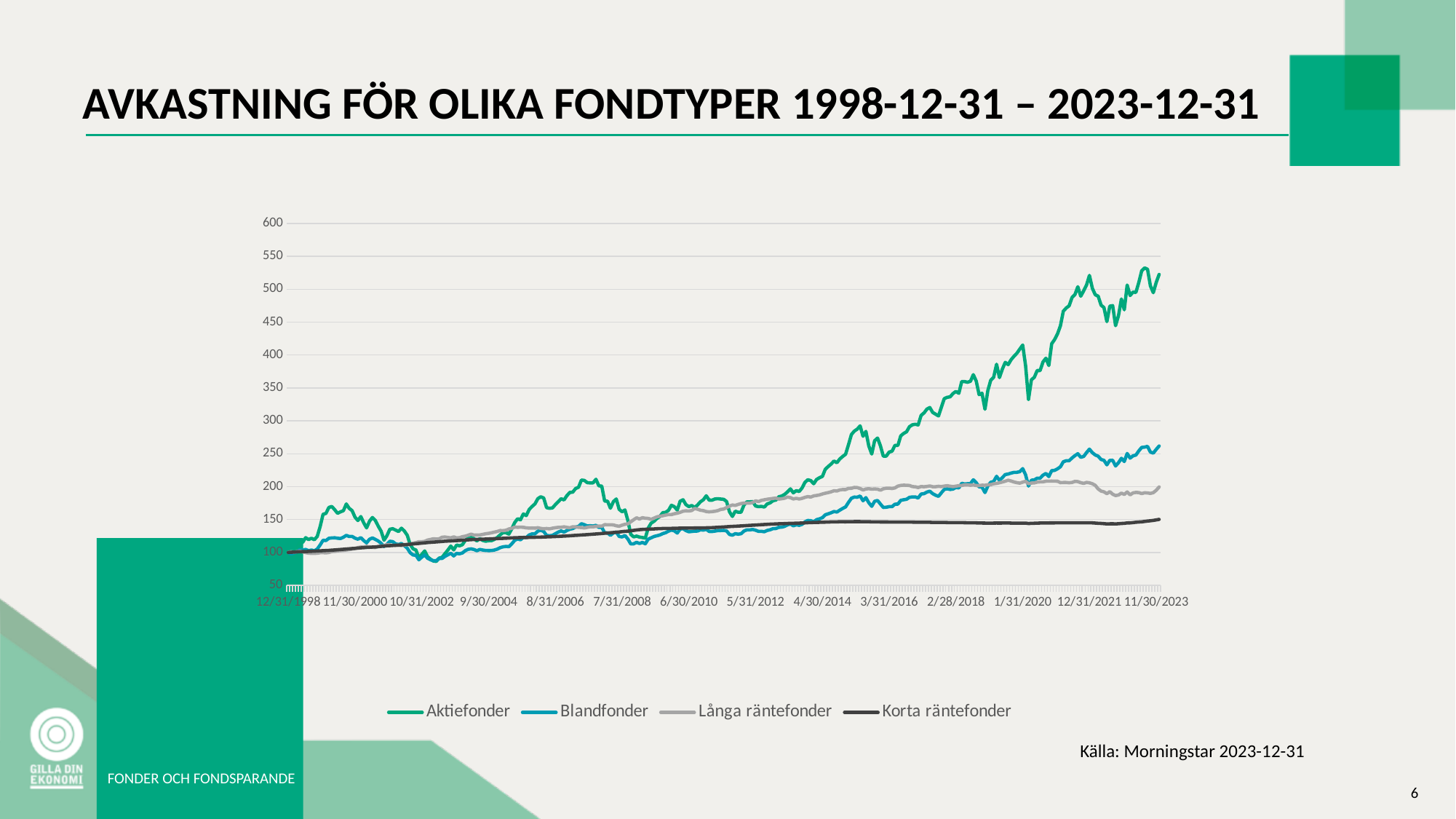
Is the value for Korta räntefonder at the end of the period greater or less than 200? less Does the Korta räntefonder line generally rise or fall over the period shown? rise Is the value for Blandfonder at the end of the period greater or less than 200? greater What is the title of the chart on the slide? AVKASTNING FÖR OLIKA FONDTYPER 1998-12-31 – 2023-12-31 Which series has the lowest value at the end of the period (11/30/2023)? Korta räntefonder At the end of the period, which is larger: Blandfonder or Långa räntefonder? Blandfonder What is the highest value shown on the vertical axis? 600 What kind of chart is shown on the slide? line chart Which series has the highest value at the end of the period (11/30/2023)? Aktiefonder Is the value for Aktiefonder at the end of the period greater or less than 500? greater Which series is drawn in green in the chart? Aktiefonder How many series does the legend list? 4